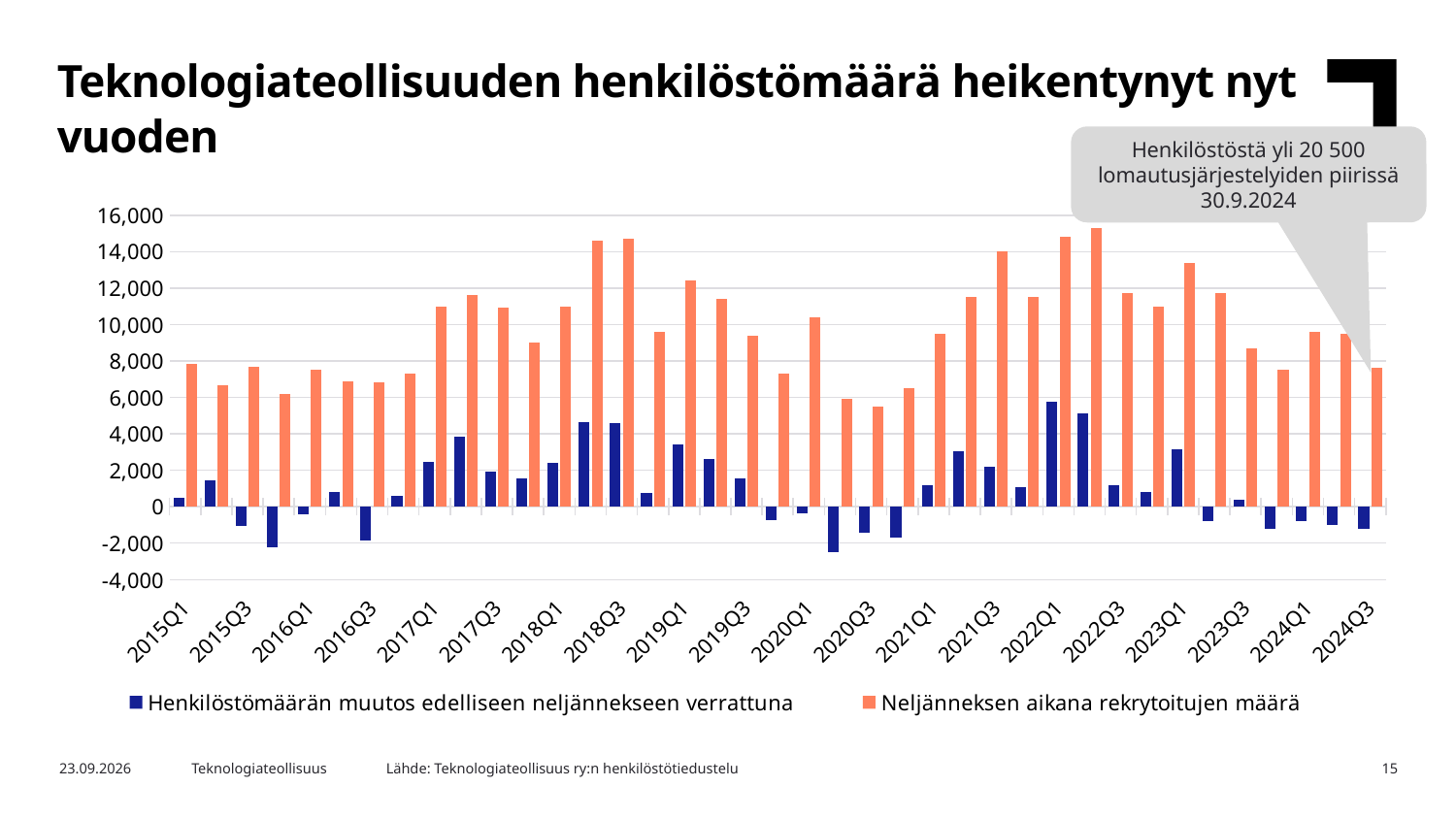
Is the value for Henkilöstömäärän muutos edelliseen neljännekseen verrattuna in 2022Q1 greater or less than 4,000? greater How many quarter labels are printed on the x axis? 20 Is the value for Neljänneksen aikana rekrytoitujen määrä in 2022Q2 greater or less than 14,000? greater What is the last quarter labelled on the x axis? 2024Q3 Is the value for Neljänneksen aikana rekrytoitujen määrä in 2024Q3 greater or less than 10,000? less How many series does the legend list? 2 Which is larger: the Henkilöstömäärän muutos edelliseen neljännekseen verrattuna value in 2022Q1 or in 2018Q3? 2022Q1 Which is larger: the Neljänneksen aikana rekrytoitujen määrä value in 2022Q2 or in 2015Q1? 2022Q2 What is the first series named in the legend? Henkilöstömäärän muutos edelliseen neljännekseen verrattuna What kind of chart is shown on the slide? Bar chart